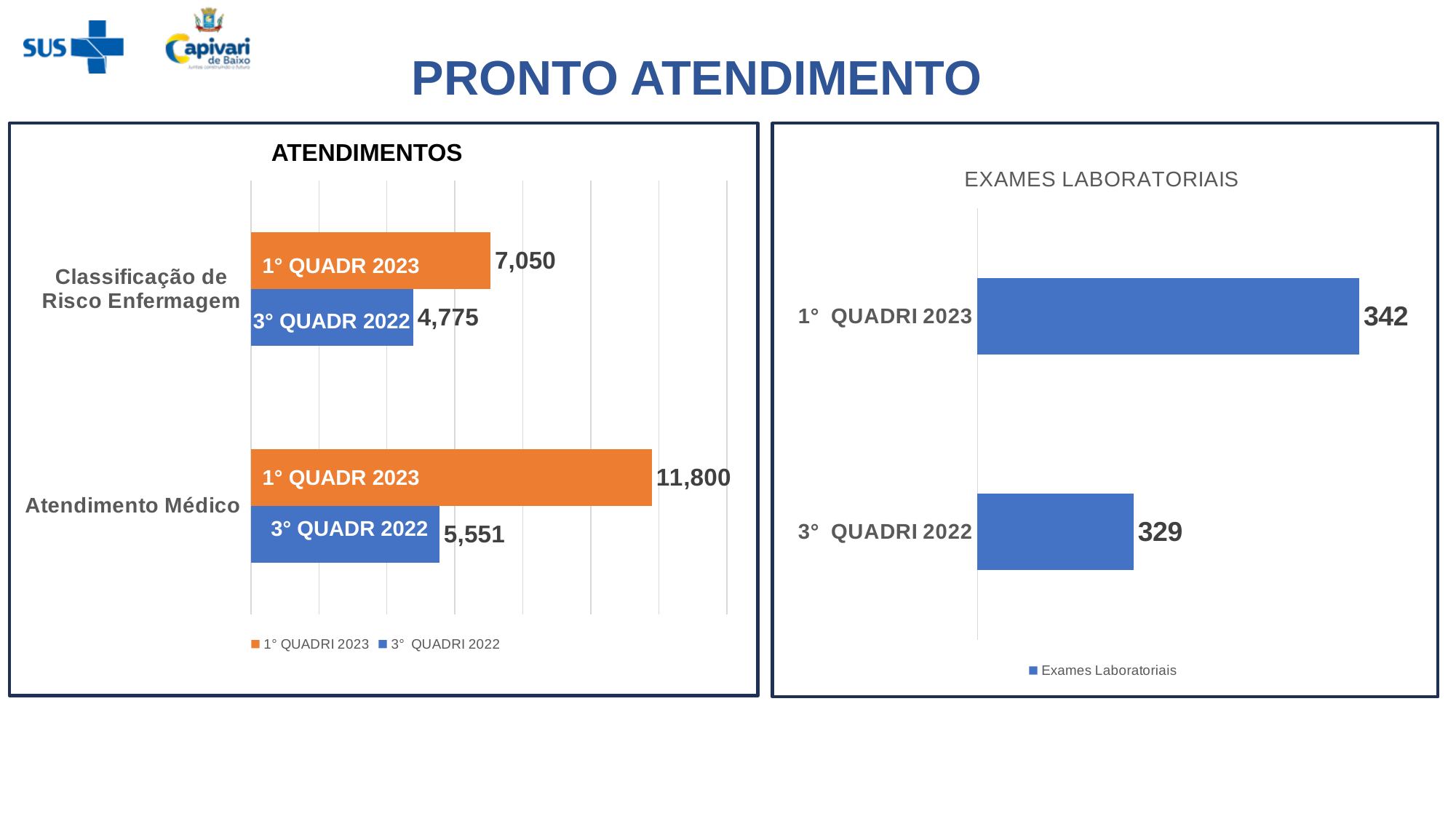
In the ATENDIMENTOS chart, what is the value for Classificação de Risco Enfermagem in 3° QUADRI 2022? 4,775 In the EXAMES LABORATORIAIS chart, what is the difference between 1° QUADRI 2023 and 3° QUADRI 2022? 13 In the ATENDIMENTOS chart, which bar has the highest value? Atendimento Médico, 1° QUADRI 2023 What kind of chart is the EXAMES LABORATORIAIS chart? Bar chart In the ATENDIMENTOS chart, what is the value for Atendimento Médico in 1° QUADRI 2023? 11,800 In the ATENDIMENTOS chart, how many series does the legend list? 2 In the EXAMES LABORATORIAIS chart, what is the value for 1° QUADRI 2023? 342 In the ATENDIMENTOS chart, what is the value for Atendimento Médico in 3° QUADRI 2022? 5,551 In the ATENDIMENTOS chart, what is the difference between the 1° QUADRI 2023 and 3° QUADRI 2022 values for Classificação de Risco Enfermagem? 2,275 In the ATENDIMENTOS chart, which colour represents 1° QUADRI 2023? Orange In the EXAMES LABORATORIAIS chart, what is the value for 3° QUADRI 2022? 329 In the ATENDIMENTOS chart, what is the difference between the 1° QUADRI 2023 and 3° QUADRI 2022 values for Atendimento Médico? 6,249